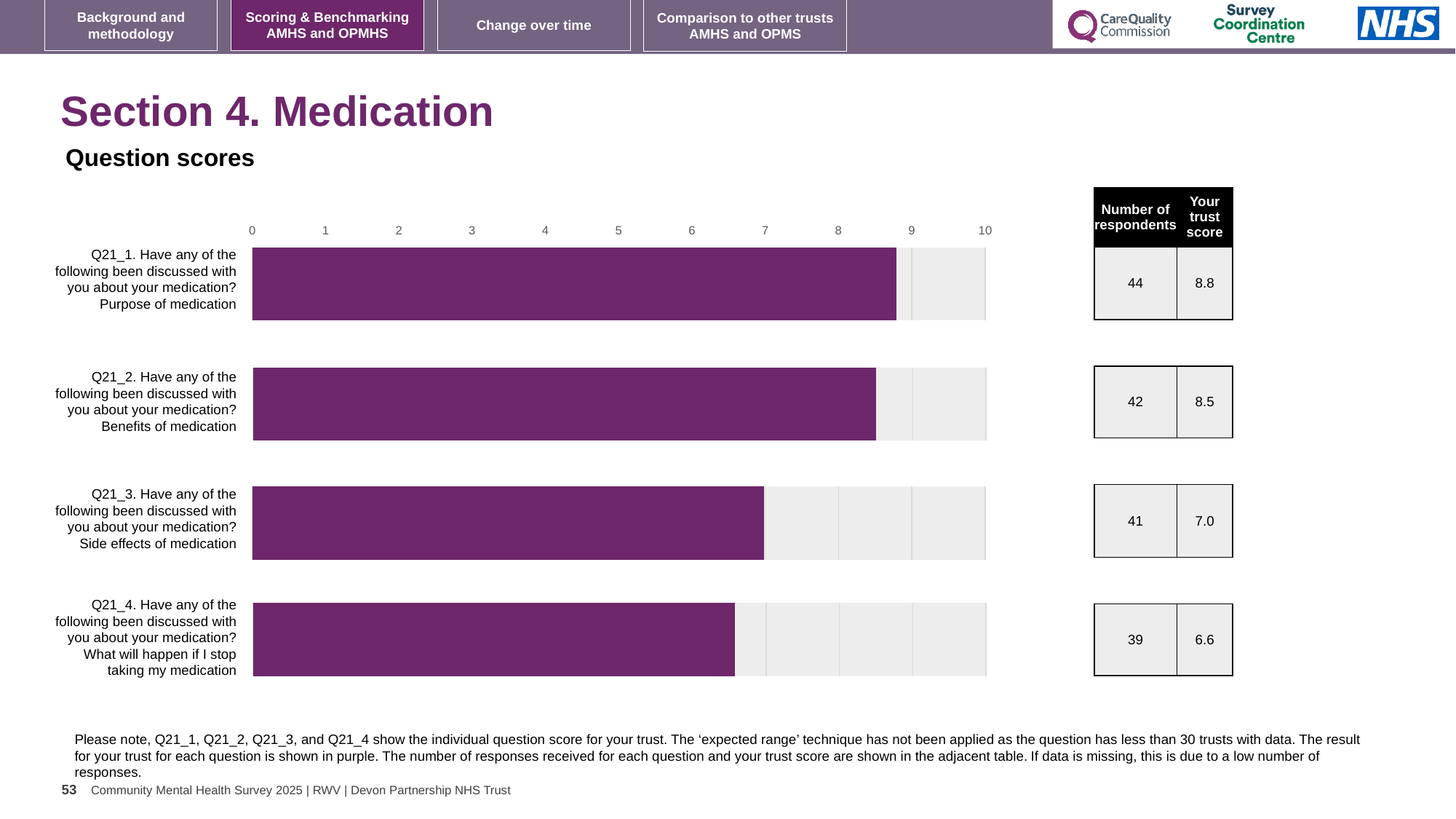
Which has a higher trust score, Q21_2 (Benefits of medication) or Q21_3 (Side effects of medication)? Q21_2. Benefits of medication What kind of chart is shown on the slide? Bar chart How many respondents answered Q21_2 (Benefits of medication)? 42 What is the trust score for Q21_1 (Purpose of medication)? 8.8 What is the maximum value shown on the chart's axis? 10 What is the trust score for Q21_3 (Side effects of medication)? 7.0 Is the trust score for Q21_3 (Side effects of medication) greater or less than 8? less Which question has the lowest trust score? Q21_4. What will happen if I stop taking my medication What is the trust score for Q21_4 (What will happen if I stop taking my medication)? 6.6 What is the difference between the trust scores for Q21_1 (Purpose of medication) and Q21_4 (What will happen if I stop taking my medication)? 2.2 How many questions are plotted in the chart? 4 Which question has the highest trust score? Q21_1. Purpose of medication